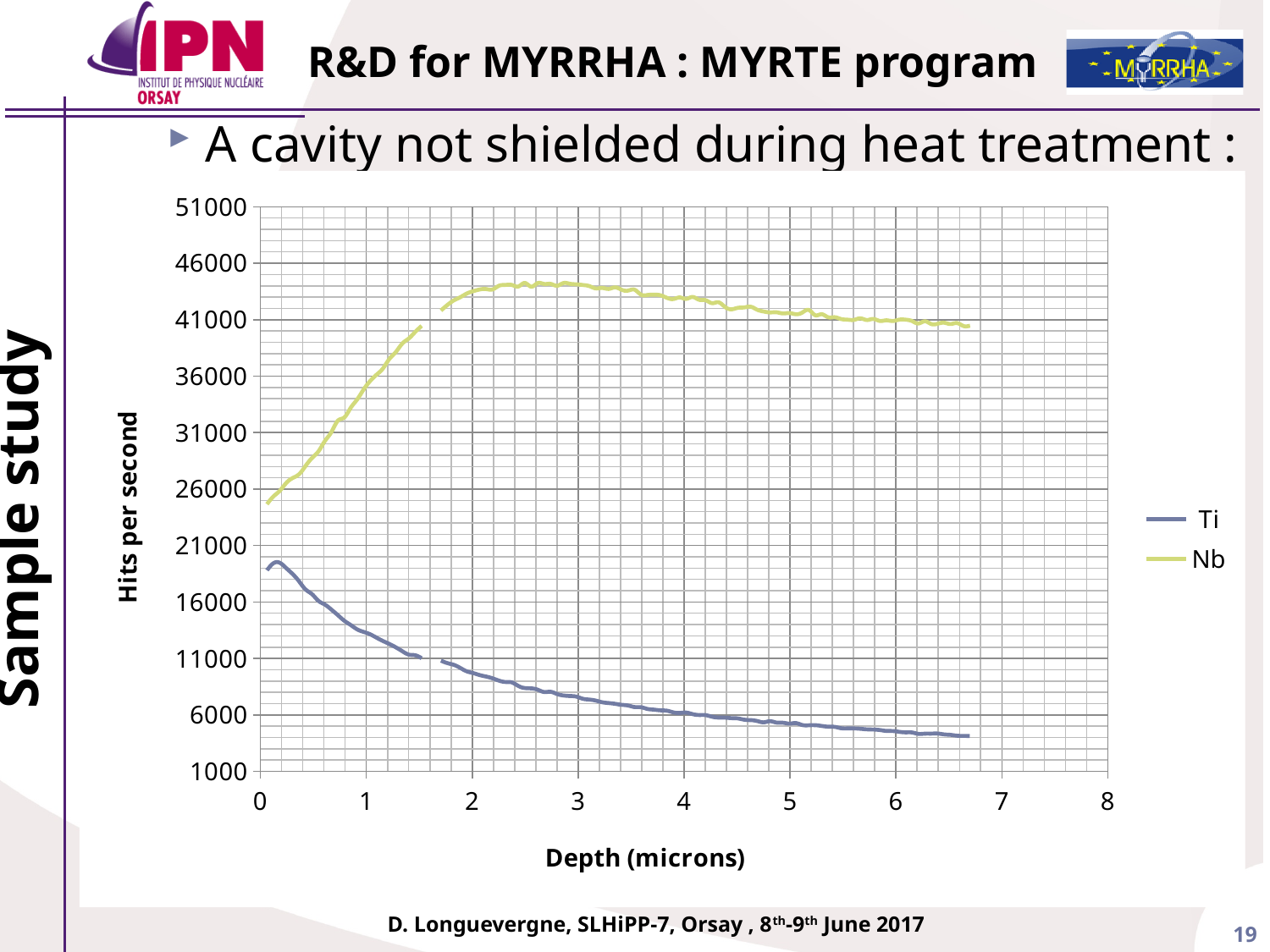
Is the value for Ti at a depth of 6 microns greater or less than 6000? less What kind of chart is shown on the slide? line chart Is the value for Ti at a depth of 3 microns greater or less than 11000? less Does the Ti series rise or fall as depth increases from 1 to 6 microns? fall Does the Nb series rise or fall as depth increases from 0 to 2 microns? rise Which series has higher values across the plotted depth range, Ti or Nb? Nb What are the two series named in the legend? Ti and Nb Is the value for Nb at a depth of 1 micron greater or less than 31000? greater How many series does the legend list? 2 What is the title of the y axis? Hits per second